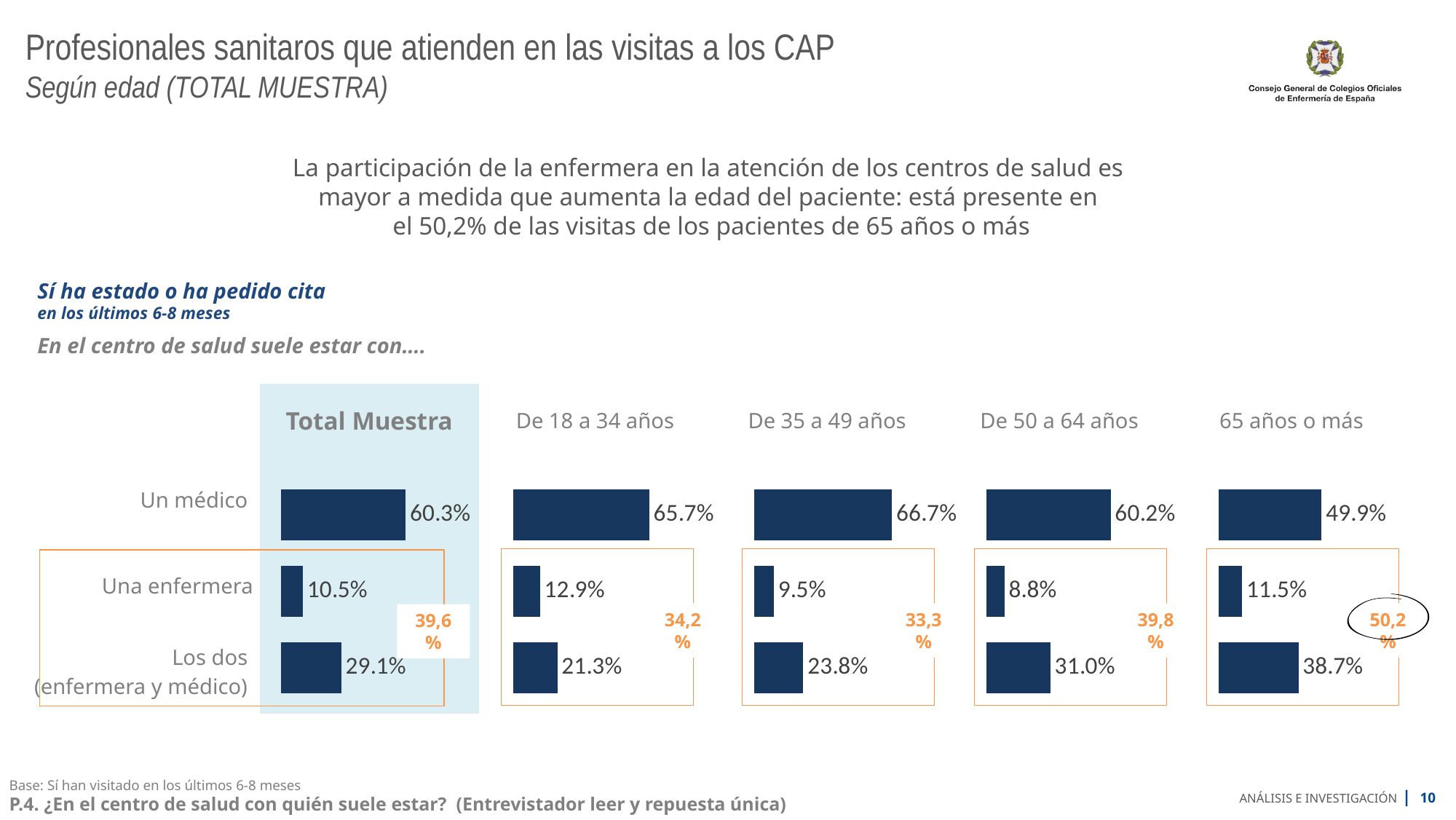
In the '65 años o más' chart, what is the value for 'Los dos (enfermera y médico)'? 38.7% In the 'Total Muestra' chart, what is the value for 'Un médico'? 60.3% How many categories are shown in the 'De 18 a 34 años' chart? 3 In the 'De 50 a 64 años' chart, what is the value for 'Los dos (enfermera y médico)'? 31.0% In the 'De 35 a 49 años' chart, what is the difference between 'Los dos (enfermera y médico)' and 'Una enfermera'? 14.3% In the 'Total Muestra' chart, which is larger: 'Una enfermera' or 'Los dos (enfermera y médico)'? Los dos (enfermera y médico) In the '65 años o más' chart, what is the difference between 'Un médico' and 'Los dos (enfermera y médico)'? 11.2% In the 'De 50 a 64 años' chart, which category has the lowest value? Una enfermera In the 'De 18 a 34 años' chart, what is the value for 'Una enfermera'? 12.9% In the 'De 35 a 49 años' chart, which category has the highest value? Un médico What kind of chart is used for the 'Total Muestra' data? Bar chart How many age-group charts (excluding 'Total Muestra') are shown on the slide? 4